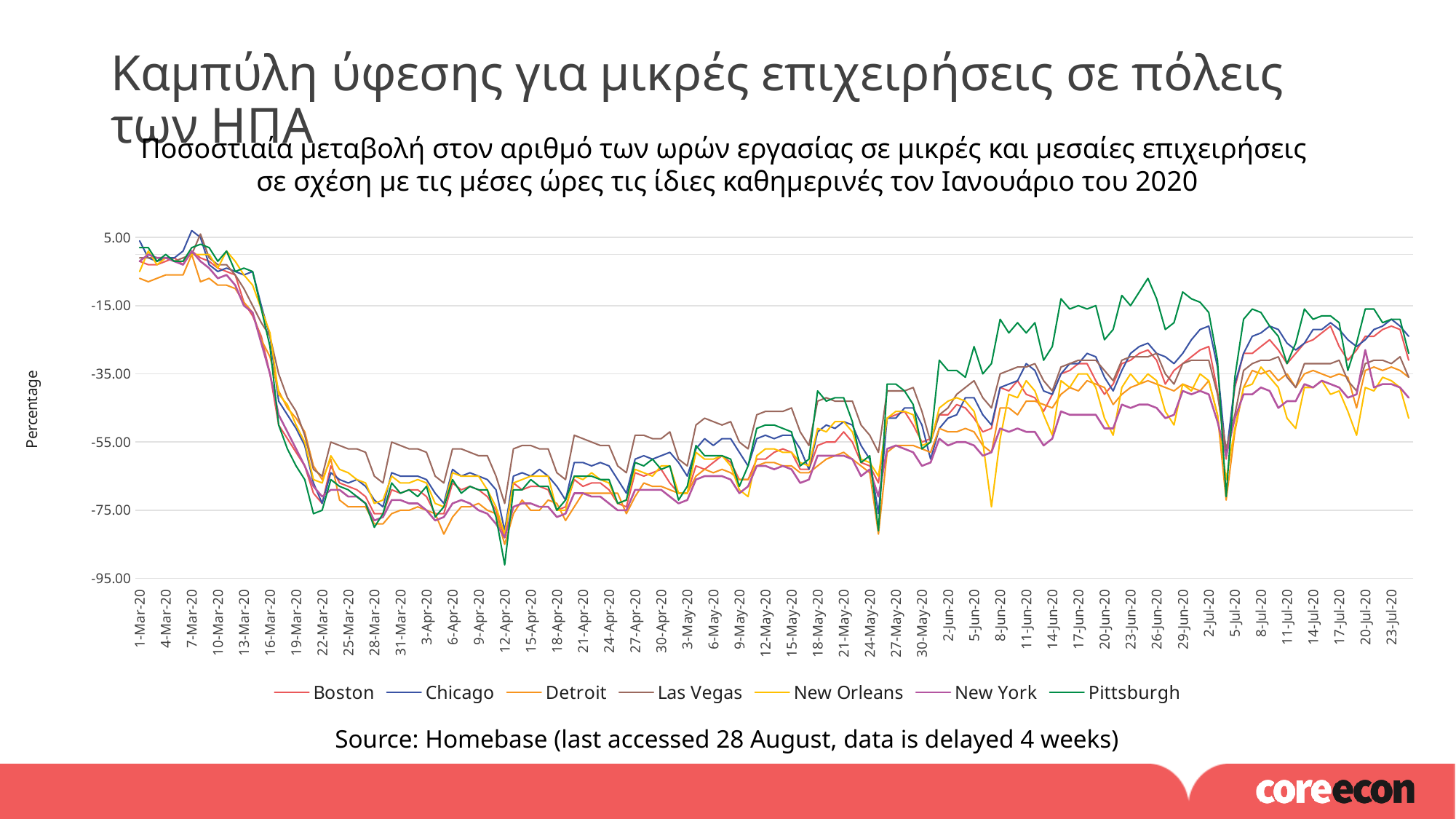
Which series is listed first in the legend? Boston What kind of chart is shown on the slide? line chart What is the label on the vertical axis? Percentage Is the value for Pittsburgh on 12-Apr-20 greater or less than -75? less Is the value for New York on 22-Mar-20 greater or less than -55? less On 26-Jun-20, which is higher: Pittsburgh or New York? Pittsburgh Do the values generally rise or fall between 12-Apr-20 and 23-Jul-20? rise How many series does the legend list? 7 Do the values rise or fall between 13-Mar-20 and 22-Mar-20? fall Is the value for Las Vegas on 1-Mar-20 greater or less than -15? greater Which series reaches the lowest value anywhere on the chart? Pittsburgh